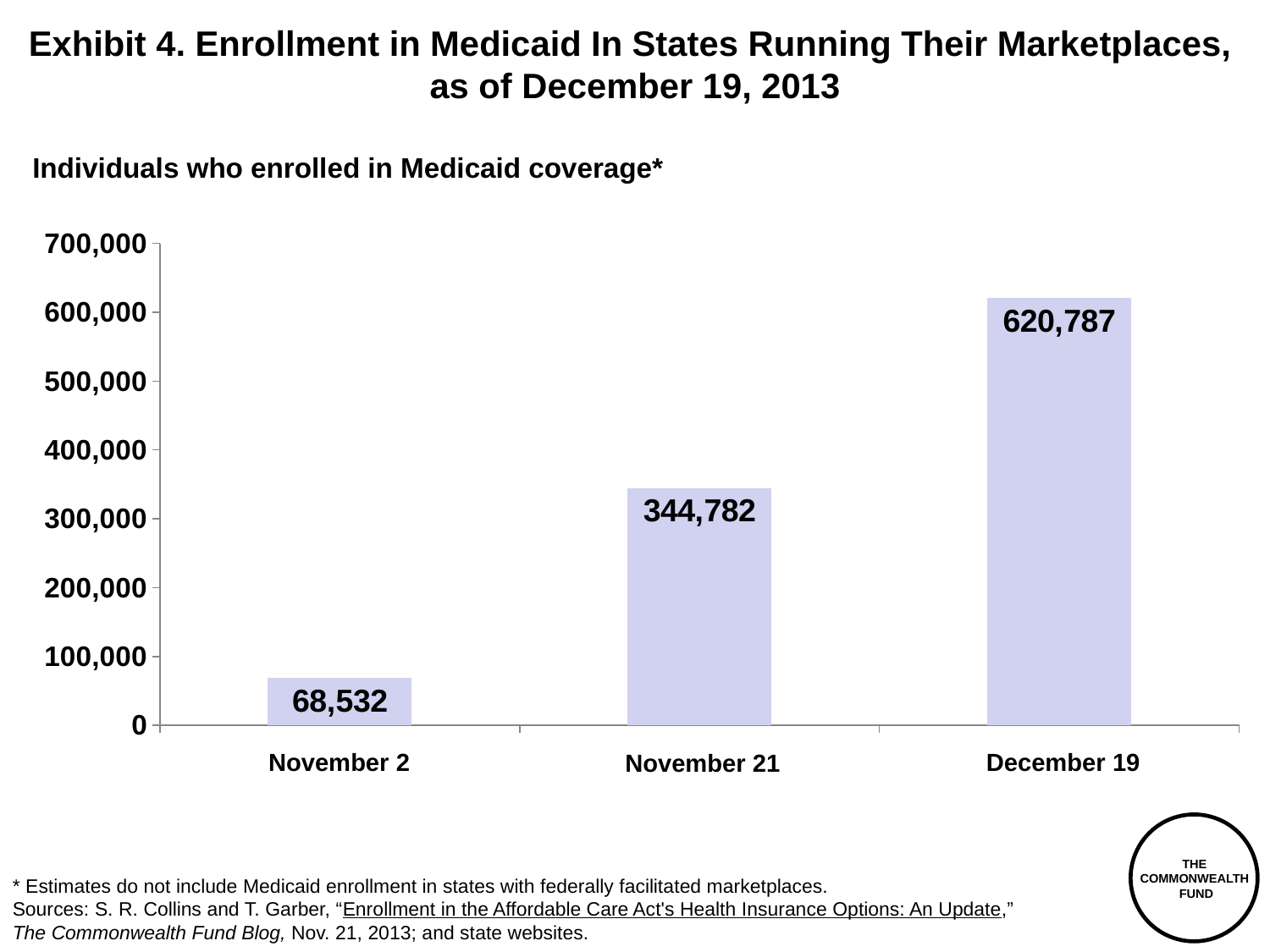
What is the difference in enrollment between December 19 and November 21? 276,005 What is the Medicaid enrollment value shown for November 2? 68,532 What is the Medicaid enrollment value shown for November 21? 344,782 Which date has the lowest Medicaid enrollment? November 2 What kind of chart is shown on the slide? Bar chart Is the value for November 21 greater or less than 300,000? greater How many dates are plotted on the chart? 3 Which date has the highest Medicaid enrollment? December 19 Do the enrollment values rise or fall from November 2 to December 19? Rise What is the Medicaid enrollment value shown for December 19? 620,787 Which is larger, the enrollment on November 21 or on December 19? December 19 What is the difference in enrollment between November 21 and November 2? 276,250